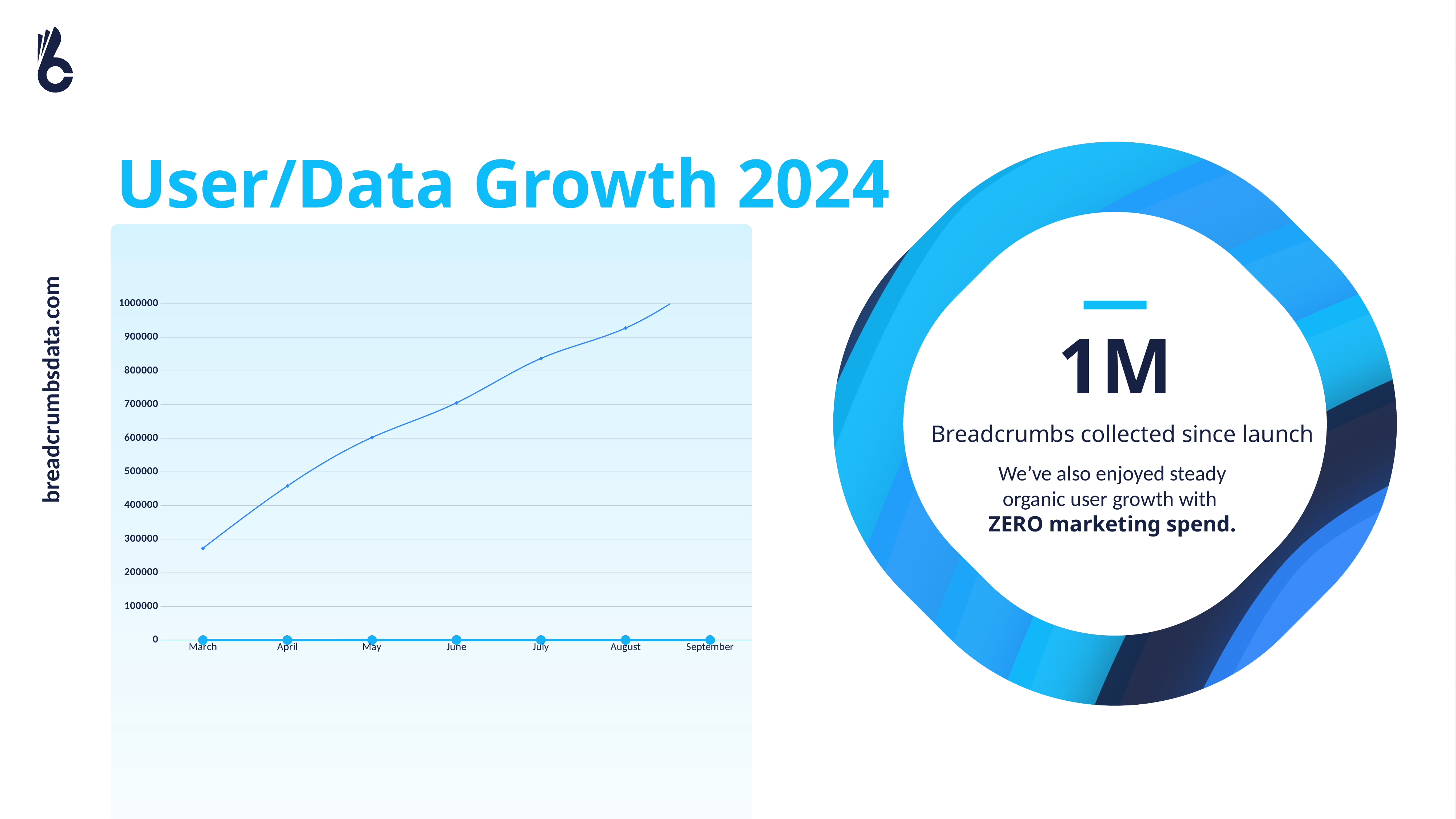
Is the value for June greater or less than 800000? less Which month has the highest value on the chart? September Is the value for April greater or less than 400000? greater What is the first month shown on the x axis of the chart? March Is the value for July greater or less than 800000? greater Do the values on the chart rise or fall from March to September? rise Which is larger, the value for July or the value for April? July Which month has the lowest value on the chart? March How many months are shown on the x axis of the chart? 7 What kind of chart is shown on the slide? line chart